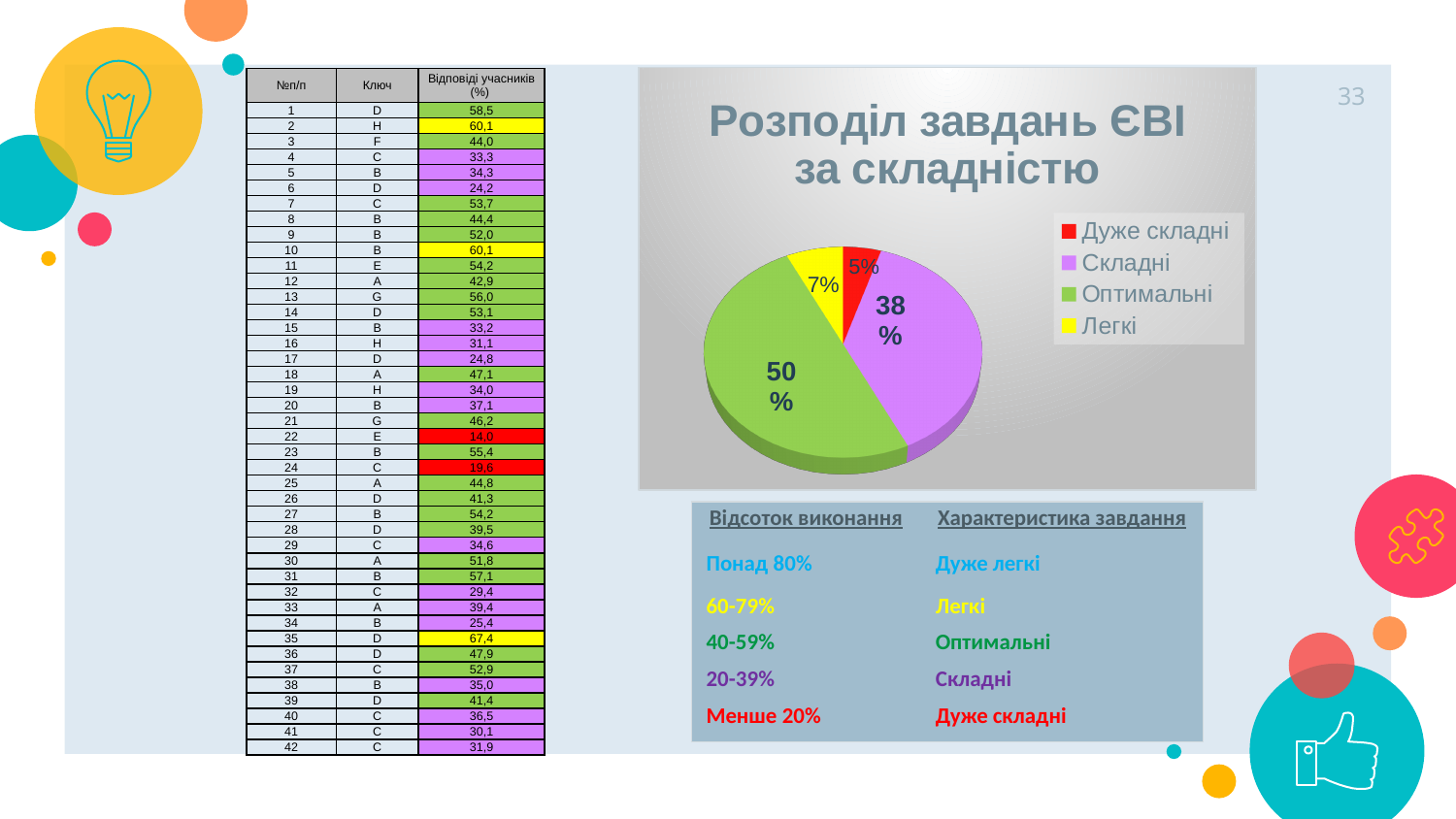
What type of chart is shown on the slide? pie chart What is the difference in percentage points between the 'Оптимальні' and 'Складні' slices? 12 What colour is the 'Складні' slice in the pie chart? purple What share of the pie does the 'Складні' slice represent? 38% Which category has the largest slice of the pie? Оптимальні What share of the pie does the 'Оптимальні' slice represent? 50% What is the title of the chart? Розподіл завдань ЄВІ за складністю What share of the pie does the 'Дуже складні' slice represent? 5% Which slice is larger, 'Легкі' or 'Дуже складні'? Легкі Which category has the smallest slice of the pie? Дуже складні How many categories does the legend of the pie chart list? 4